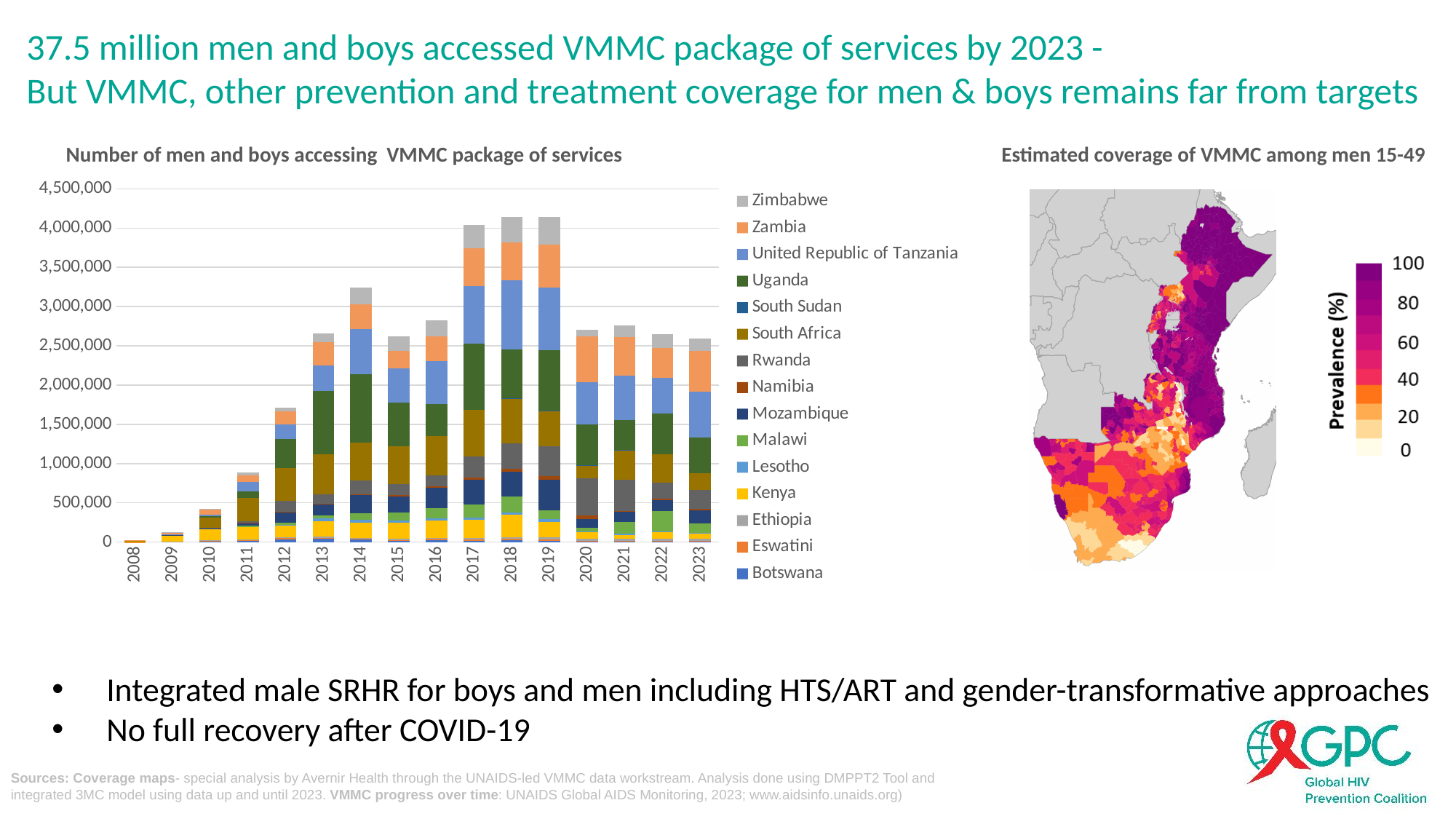
Is the total for 2014 in the bar chart greater or less than 3,000,000? greater Is the total for 2011 in the bar chart greater or less than 1,000,000? less How many years are shown on the x axis of the bar chart? 16 In the bar chart, which year has a larger total: 2013 or 2014? 2014 Is the total for 2008 in the bar chart greater or less than 500,000? less Do the totals in the bar chart rise or fall from 2008 to 2014? rise Which year has the lowest total number of men and boys accessing VMMC services in the bar chart? 2008 In the bar chart, which year has a larger total: 2017 or 2020? 2017 How many countries does the legend of the bar chart list? 15 What is the title of the bar chart on the left of the slide? Number of men and boys accessing VMMC package of services What kind of chart is used to show the number of men and boys accessing the VMMC package of services? Stacked bar chart